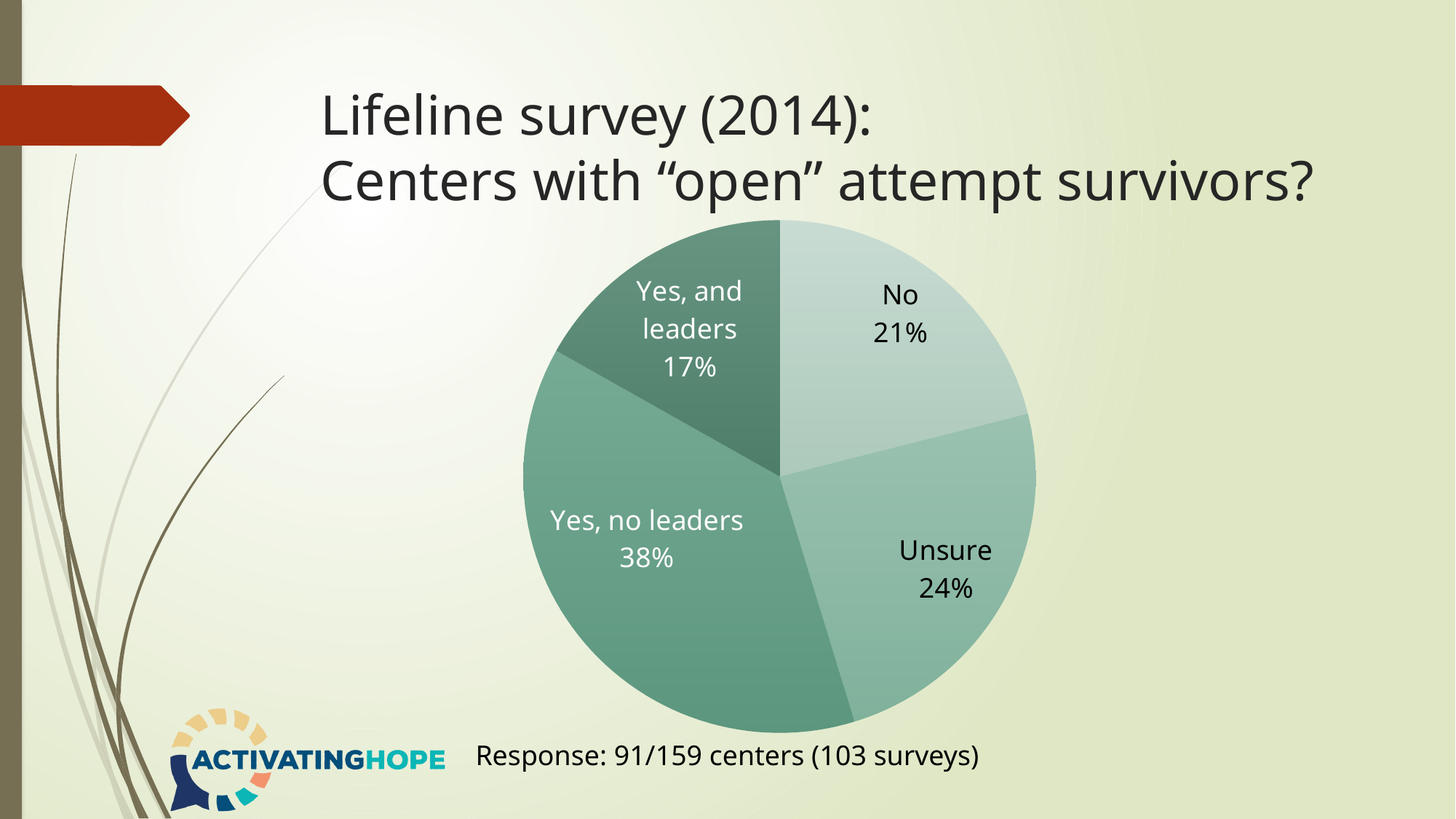
Which is larger, the share for "Unsure" or the share for "No"? Unsure What is the title of the slide containing the chart? Lifeline survey (2014): Centers with "open" attempt survivors? What percentage of centers answered "Unsure"? 24% What percentage of centers answered "Yes, and leaders"? 17% Which response has the smallest share of the pie? Yes, and leaders According to the note below the chart, how many centers responded to the survey? 91/159 centers What kind of chart is shown on the slide? pie chart Which response has the largest share of the pie? Yes, no leaders What is the difference in percentage points between "Yes, no leaders" and "Yes, and leaders"? 21 How many slices does the pie chart have? 4 What percentage of centers answered "Yes, no leaders"? 38% What percentage of centers answered "No"? 21%